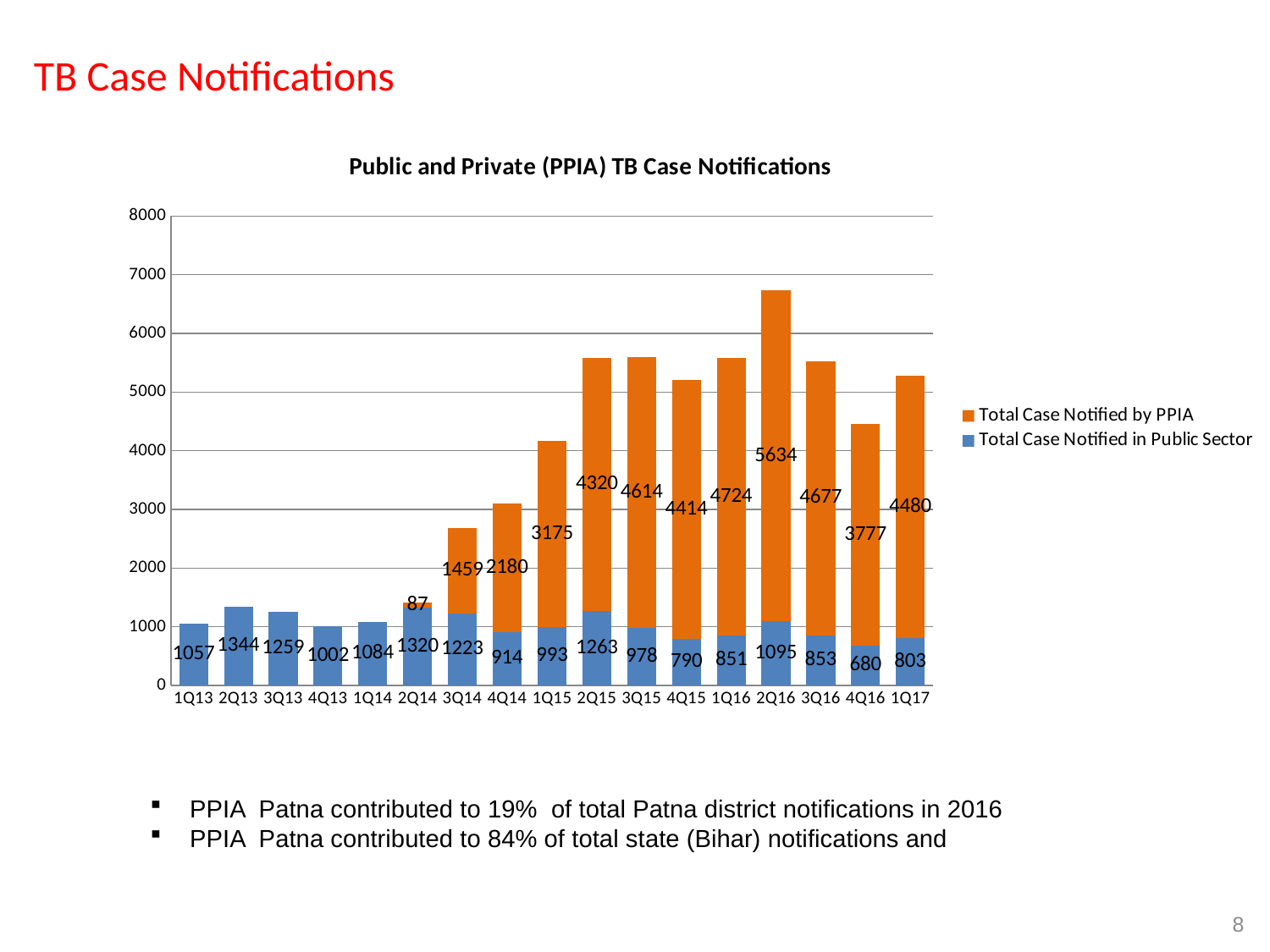
Does Total Case Notified by PPIA rise or fall from 2Q14 to 2Q16? Rise Which is larger, Total Case Notified by PPIA in 3Q15 or in 4Q15? 3Q15 What is the value for Total Case Notified by PPIA in 2Q16? 5634 What is the difference between Total Case Notified by PPIA in 2Q16 and 1Q16? 910 In which quarter is Total Case Notified in Public Sector highest? 2Q13 In which quarter is Total Case Notified in Public Sector lowest? 4Q16 What is the total height of the stacked bar for 1Q17? 5283 What type of chart is shown on the slide? Stacked bar chart How many quarters are shown on the x axis? 17 What is the value for Total Case Notified by PPIA in 2Q14? 87 What is the value for Total Case Notified in Public Sector in 4Q13? 1002 How many series does the legend list? 2